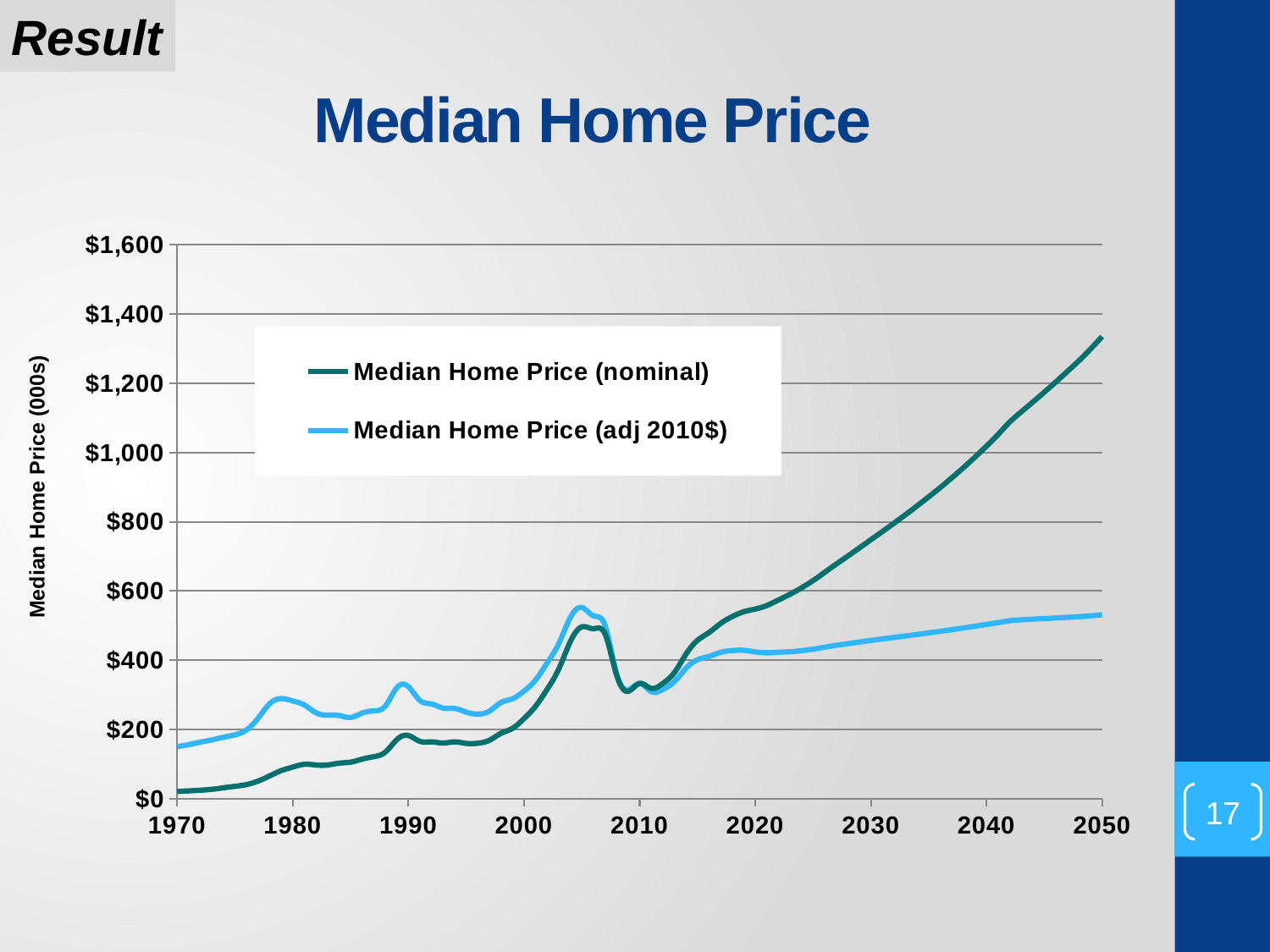
Does the Median Home Price (nominal) series rise or fall between 2010 and 2050? rise Is the value for Median Home Price (nominal) in 1970 greater or less than $200? less Is the value for Median Home Price (adj 2010$) in 2050 greater or less than $600? less What kind of chart is shown on the slide? line chart In 1990, which series has the larger value, Median Home Price (nominal) or Median Home Price (adj 2010$)? Median Home Price (adj 2010$) Is the value for Median Home Price (nominal) in 2020 greater or less than $600? less What is the label on the vertical axis? Median Home Price (000s) What is the title of the chart? Median Home Price In 2050, which series has the larger value, Median Home Price (nominal) or Median Home Price (adj 2010$)? Median Home Price (nominal) How many series does the legend list? 2